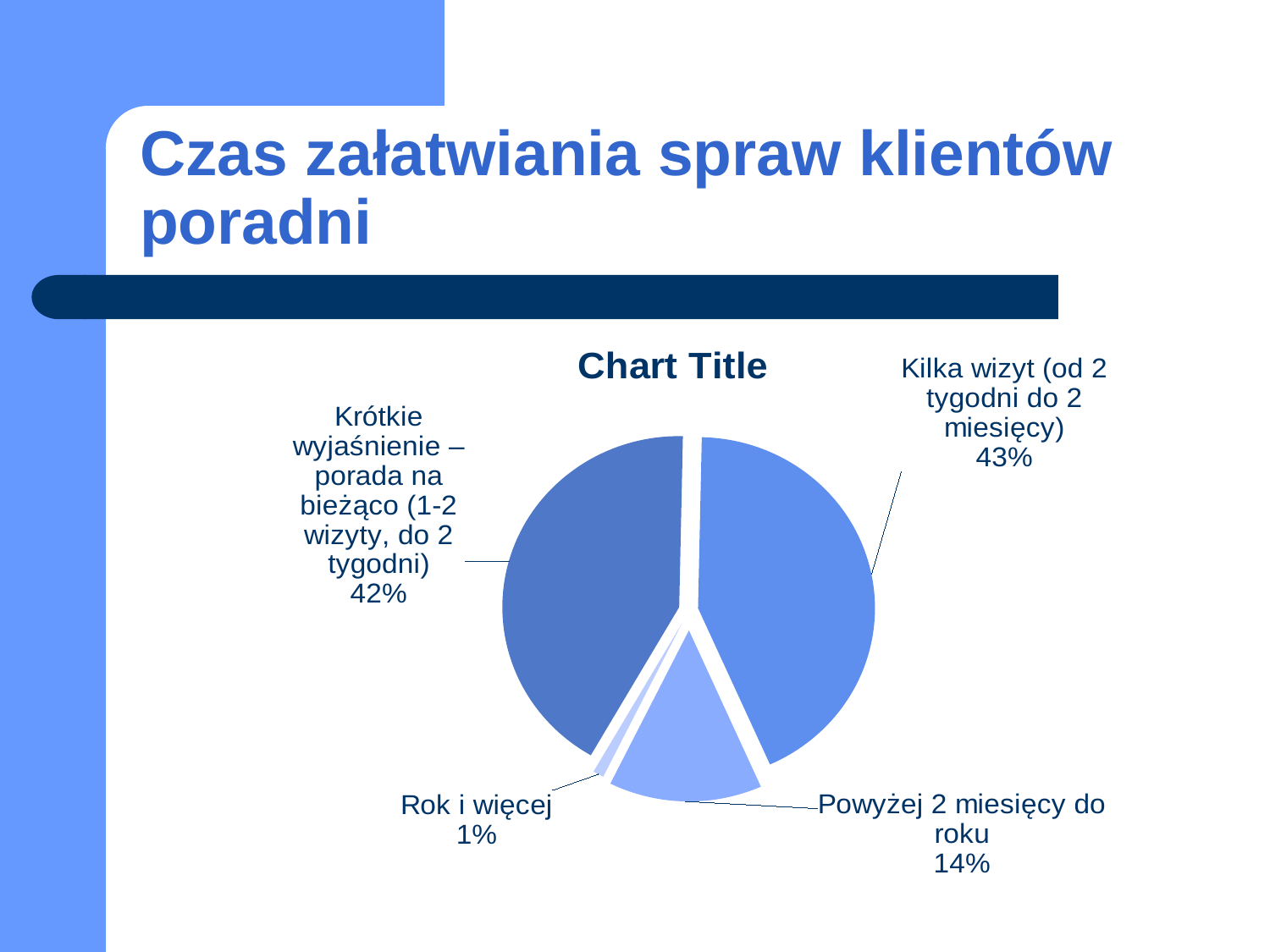
What share of the pie is labelled "Krótkie wyjaśnienie – porada na bieżąco (1-2 wizyty, do 2 tygodni)"? 42% What share of the pie is labelled "Powyżej 2 miesięcy do roku"? 14% What is the difference in percentage points between "Powyżej 2 miesięcy do roku" and "Rok i więcej"? 13 Which category has the smallest share of the pie? Rok i więcej How many slices does the pie chart have? 4 What share of the pie is labelled "Kilka wizyt (od 2 tygodni do 2 miesięcy)"? 43% What is the difference in percentage points between "Kilka wizyt (od 2 tygodni do 2 miesięcy)" and "Powyżej 2 miesięcy do roku"? 29 Which category has the largest share of the pie? Kilka wizyt (od 2 tygodni do 2 miesięcy) What title is printed above the pie chart? Chart Title Which is larger: the share for "Powyżej 2 miesięcy do roku" or the share for "Rok i więcej"? Powyżej 2 miesięcy do roku What kind of chart is shown on the slide? pie chart What share of the pie is labelled "Rok i więcej"? 1%